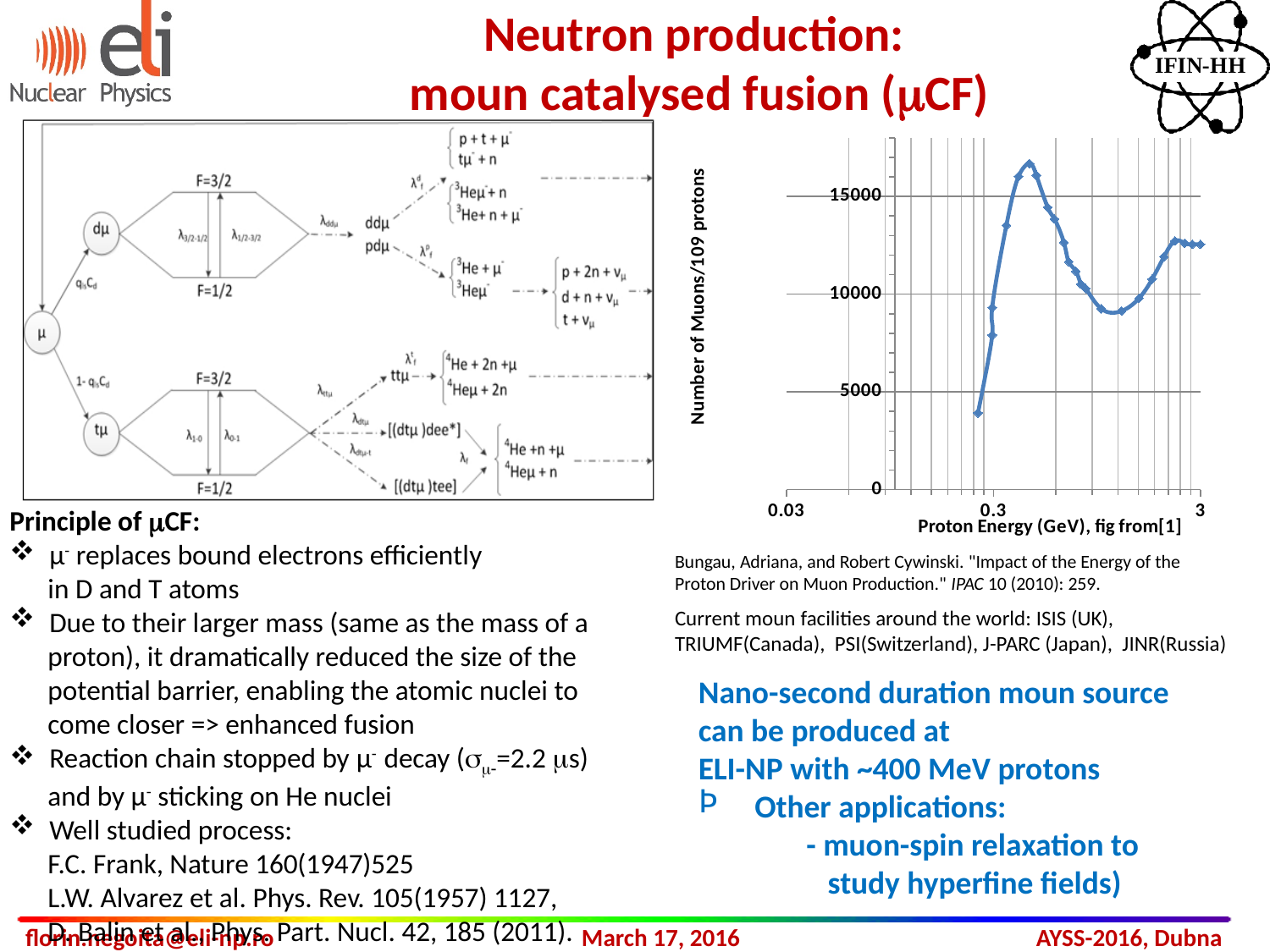
Is the value of the curve at its lowest-energy point (near 0.25 GeV) greater or less than 5000? less What is the highest value shown on the y axis of the chart? 15000 Is the value of the curve at 3 GeV greater or less than 15000? less What kind of chart is shown on the right side of the slide? line chart Is the peak value of the curve greater or less than 15000? greater Which is larger: the number of muons at the peak near 0.4 GeV or the number of muons at 3 GeV? the peak near 0.4 GeV Does the number of muons rise or fall as proton energy increases from about 0.4 GeV to about 1 GeV? fall What is the title of the y axis of the chart? Number of Muons/109 protons Does the number of muons rise or fall as proton energy increases from 0.3 GeV to about 0.4 GeV? rise What is the title of the x axis of the chart? Proton Energy (GeV), fig from[1]